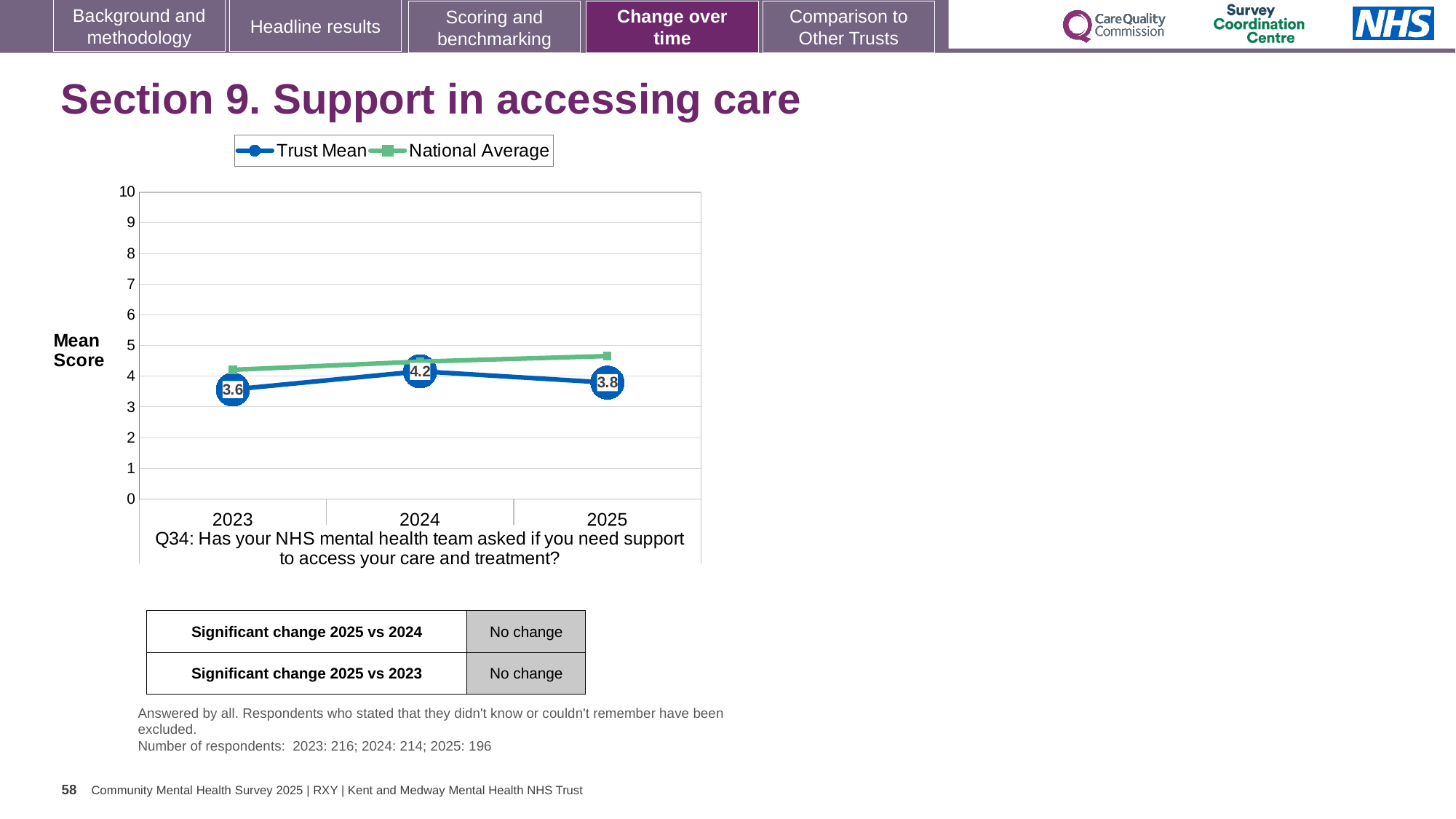
What kind of chart is shown on the slide? Line chart Does the National Average line rise or fall from 2023 to 2025? Rise What is the Trust Mean score for 2025? 3.8 In which year is the Trust Mean lowest? 2023 How many series does the legend list? 2 What is the difference between the Trust Mean in 2024 and in 2023? 0.6 How many years are plotted on the x axis? 3 What is the Trust Mean score for 2023? 3.6 Which is larger, the Trust Mean in 2025 or the Trust Mean in 2023? 2025 Is the National Average value for 2025 greater or less than 4? greater In which year is the Trust Mean highest? 2024 What is the Trust Mean score for 2024? 4.2